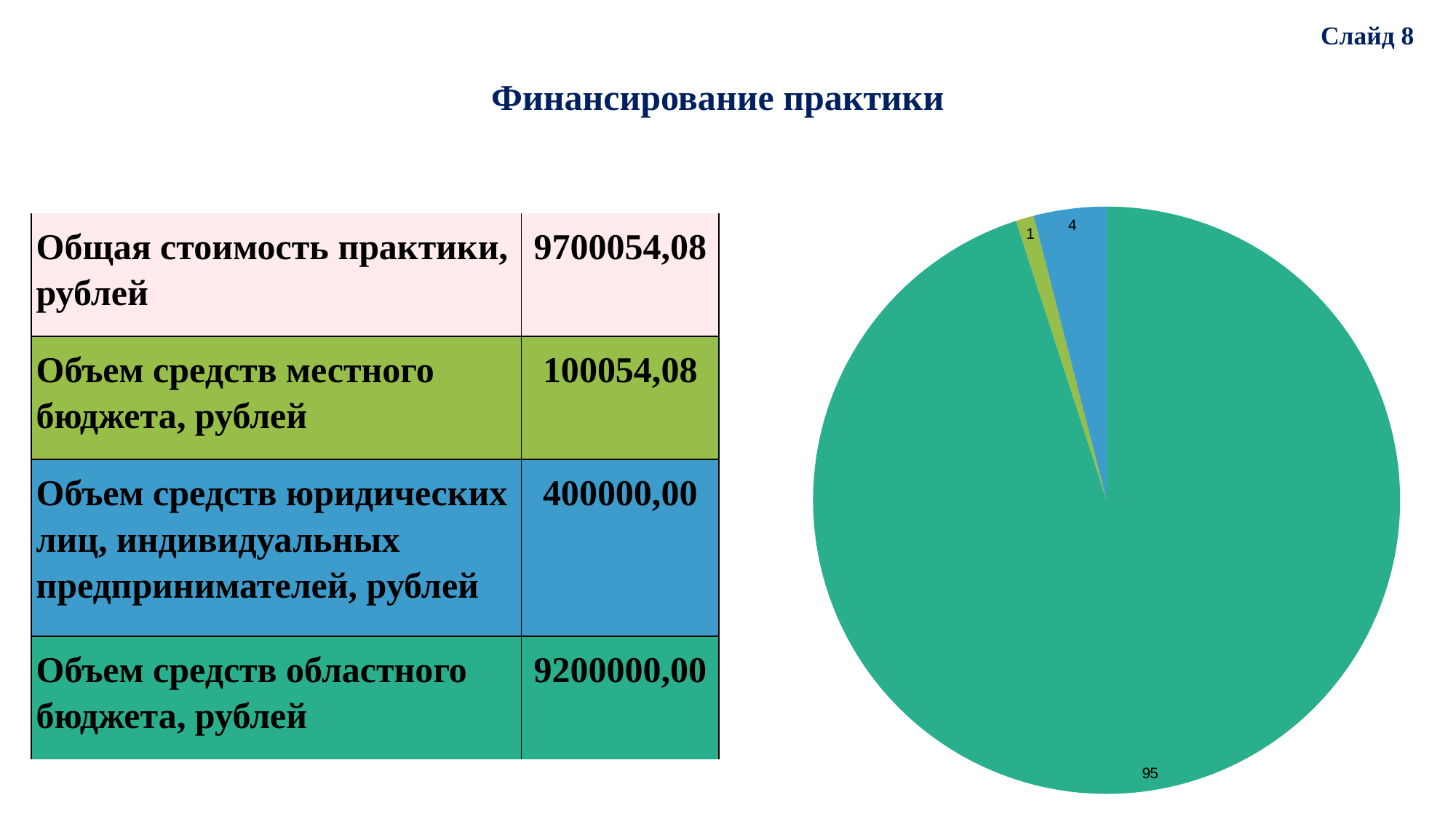
What is the title of the slide containing the pie chart? Финансирование практики What value is printed on the teal slice of the pie chart? 95 Which colour is the largest slice of the pie chart? teal (green-blue) What kind of chart is shown on the slide? pie chart What is the value printed on the smallest slice of the pie chart? 1 What is the value printed on the largest slice of the pie chart? 95 How many slices does the pie chart have? 3 Which slice of the pie chart has the larger printed value, the blue slice or the green slice? blue slice What value is printed on the green slice of the pie chart? 1 What is the difference between the values printed on the teal slice and the blue slice of the pie chart? 91 What is the total of the three values printed on the pie chart slices? 100 What value is printed on the blue slice of the pie chart? 4